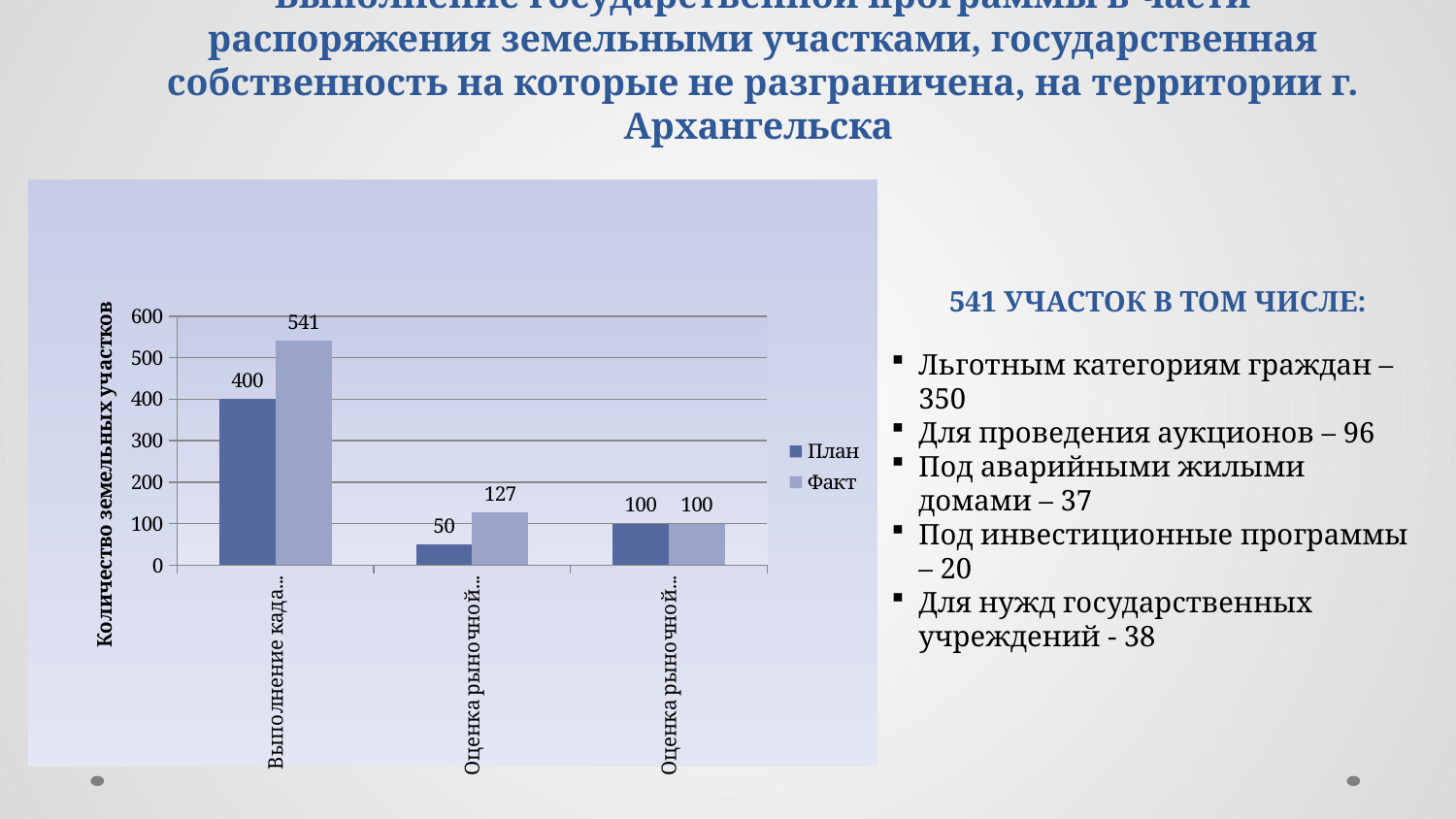
What is the Факт value for the second category on the x axis? 127 What is the План value for the first category (Выполнение када...)? 400 Which category has the highest Факт value? Выполнение када... (the first category) How many series does the chart legend list? 2 What is the Факт value for the third category on the x axis? 100 How many categories are shown on the x axis of the chart? 3 What is the План value for the second category on the x axis? 50 For the second category on the x axis, which is larger: the План value or the Факт value? Факт What is the difference between the Факт and План values for the first category (Выполнение када...)? 141 What is the Факт value for the first category (Выполнение када...)? 541 What are the two series named in the chart legend? План and Факт What type of chart is shown on the slide? bar chart